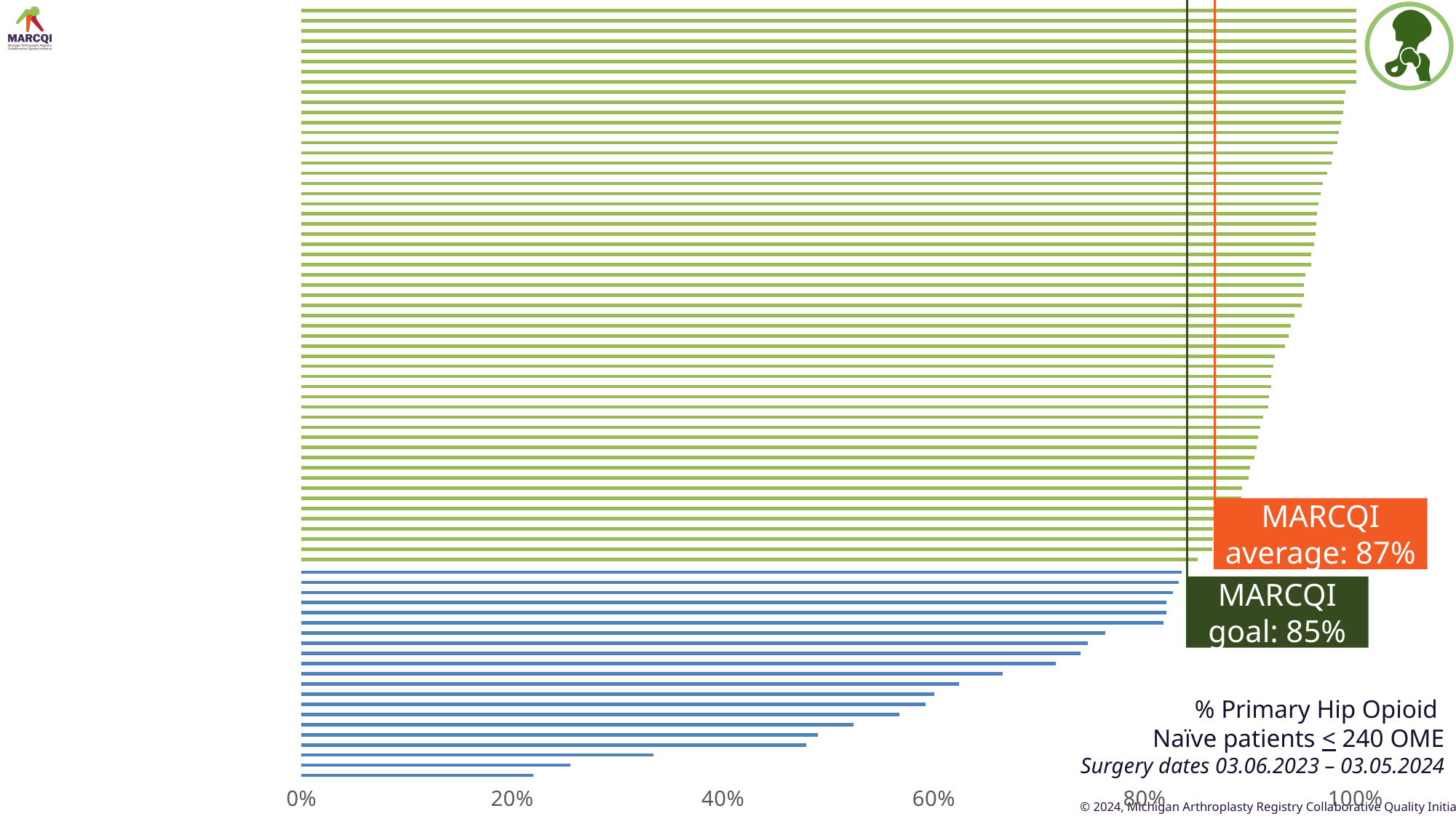
What is the MARCQI average shown on the chart? 87% Is the value of the longest bar greater or less than 80%? greater What is the MARCQI goal shown on the chart? 85% Are the blue bars at the bottom of the chart above or below the MARCQI goal line? below What is the highest value shown on the x axis? 100% What kind of chart is shown on the slide? Bar chart Do the bar values rise or fall moving from the top of the chart to the bottom? fall By how many percentage points does the MARCQI average exceed the MARCQI goal? 2 percentage points What surgery date range does the chart cover? 03.06.2023 – 03.05.2024 Which is larger, the MARCQI average or the MARCQI goal? MARCQI average Is the value of the shortest bar (at the bottom of the chart) greater or less than 40%? less What measure does the chart title say is plotted? % Primary Hip Opioid Naïve patients ≤ 240 OME